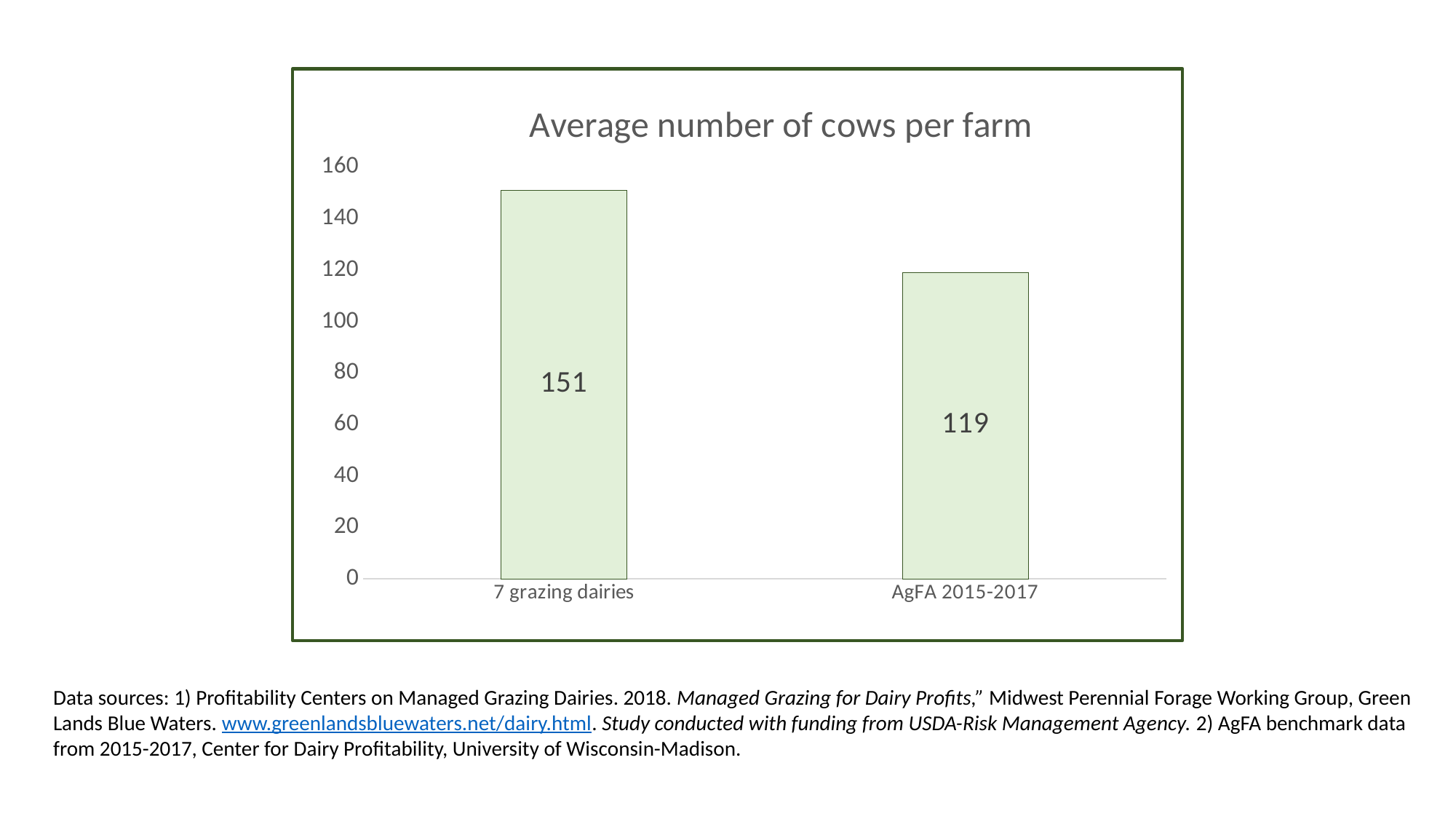
Which category has the lower average number of cows per farm? AgFA 2015-2017 Is the value for AgFA 2015-2017 greater or less than 120? less Is the value for 7 grazing dairies greater or less than 140? greater What is the difference in average number of cows per farm between the 7 grazing dairies and AgFA 2015-2017? 32 How many categories are shown on the chart? 2 Which category has the higher average number of cows per farm? 7 grazing dairies What kind of chart is shown on the slide? Bar chart What is the highest value shown on the vertical axis of the chart? 160 What is the average number of cows per farm for AgFA 2015-2017? 119 What is the title of the chart? Average number of cows per farm What is the average number of cows per farm for the 7 grazing dairies? 151 Is the average number of cows per farm larger for the 7 grazing dairies or for AgFA 2015-2017? 7 grazing dairies